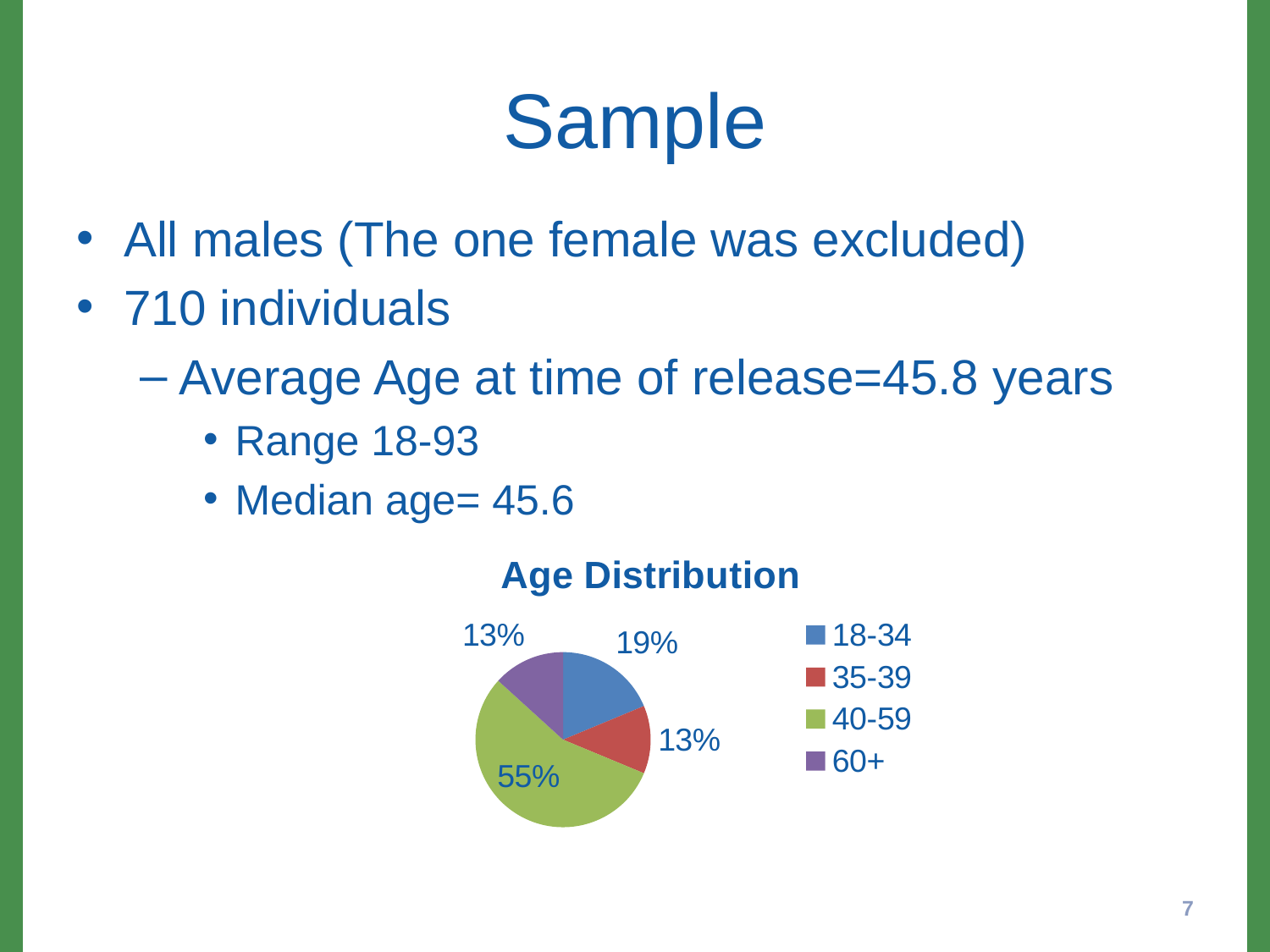
What percentage of the sample is in the 40-59 age group? 55% What percentage of the sample is in the 60+ age group? 13% What percentage of the sample is in the 35-39 age group? 13% Which is larger, the share for 18-34 or the share for 35-39? 18-34 What is the difference in percentage points between the 40-59 group and the 18-34 group? 36 What colour represents the 40-59 age group in the pie chart? green What is the title of the chart? Age Distribution What type of chart is shown on the slide? pie chart How many age groups are shown in the pie chart? 4 How many entries does the legend list? 4 Which age group has the largest share of the pie? 40-59 What percentage of the sample is in the 18-34 age group? 19%